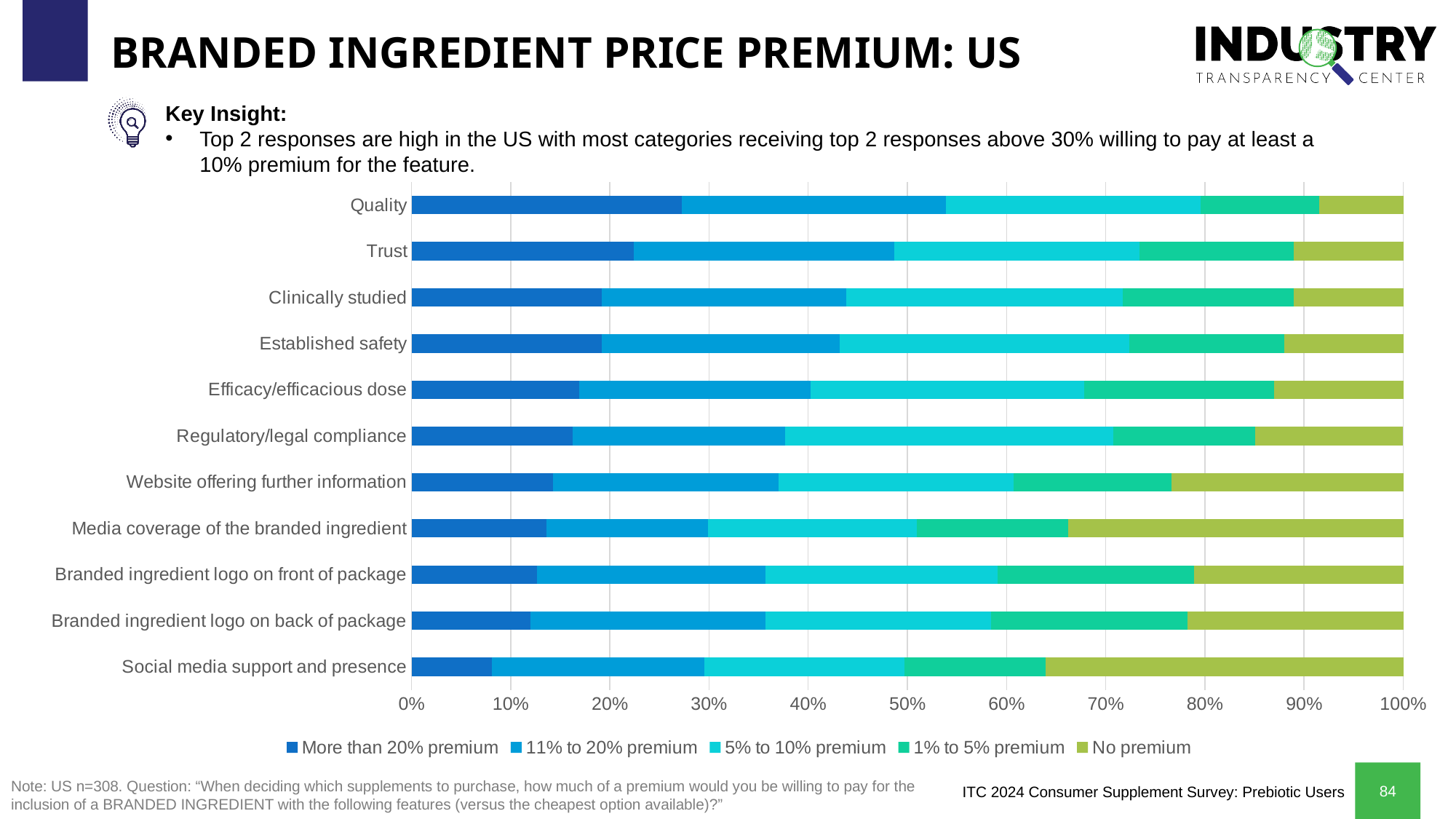
Is the 'More than 20% premium' value for Quality greater or less than 20%? greater Which category has the smallest 'No premium' segment? Quality How many series does the chart legend list? 5 Is the 'More than 20% premium' value for Social media support and presence greater or less than 10%? less Which category has the smallest 'More than 20% premium' segment? Social media support and presence Is the 'More than 20% premium' value for Regulatory/legal compliance greater or less than 20%? less Which category has the largest 'More than 20% premium' segment? Quality How many categories (features) are plotted on the chart? 11 Moving down the categories from Quality to Social media support and presence, does the 'More than 20% premium' segment generally increase or decrease? decrease What is the title of the chart slide? BRANDED INGREDIENT PRICE PREMIUM: US Which has a larger 'More than 20% premium' segment: Quality or Social media support and presence? Quality What kind of chart is shown on the slide? Stacked bar chart